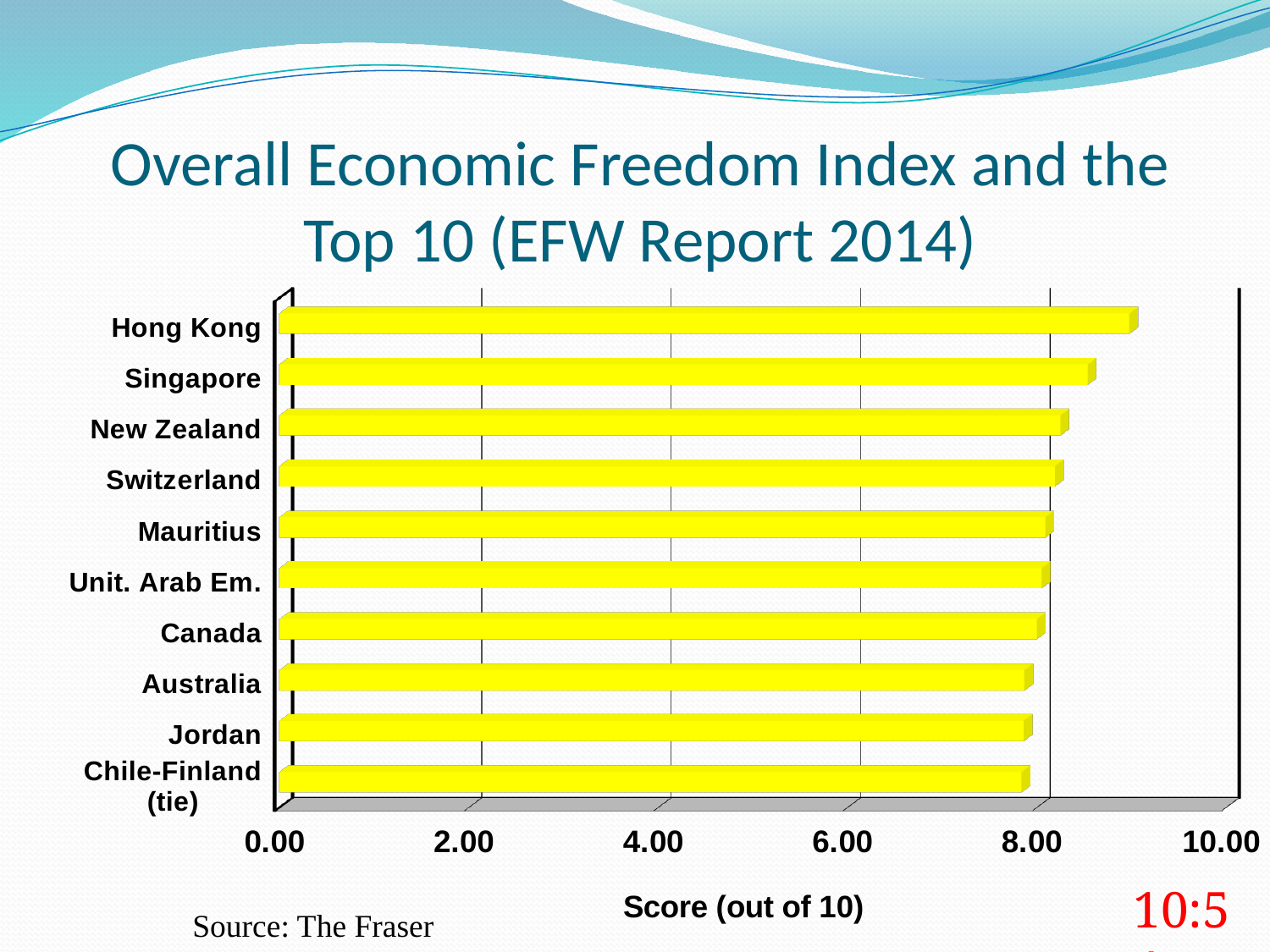
What kind of chart is shown on the slide? bar chart Which has the larger score, Singapore or Australia? Singapore Do the bar lengths increase or decrease going from the top entry to the bottom entry? decrease What is the label of the horizontal axis? Score (out of 10) Which entry has the highest score in the chart? Hong Kong How many countries or entries are plotted in the chart? 10 Is the value for Hong Kong greater or less than 10.00? less Is the value for Chile-Finland (tie) greater or less than 8.00? less Is the value for Jordan greater or less than 6.00? greater Which has the larger score, Hong Kong or Singapore? Hong Kong